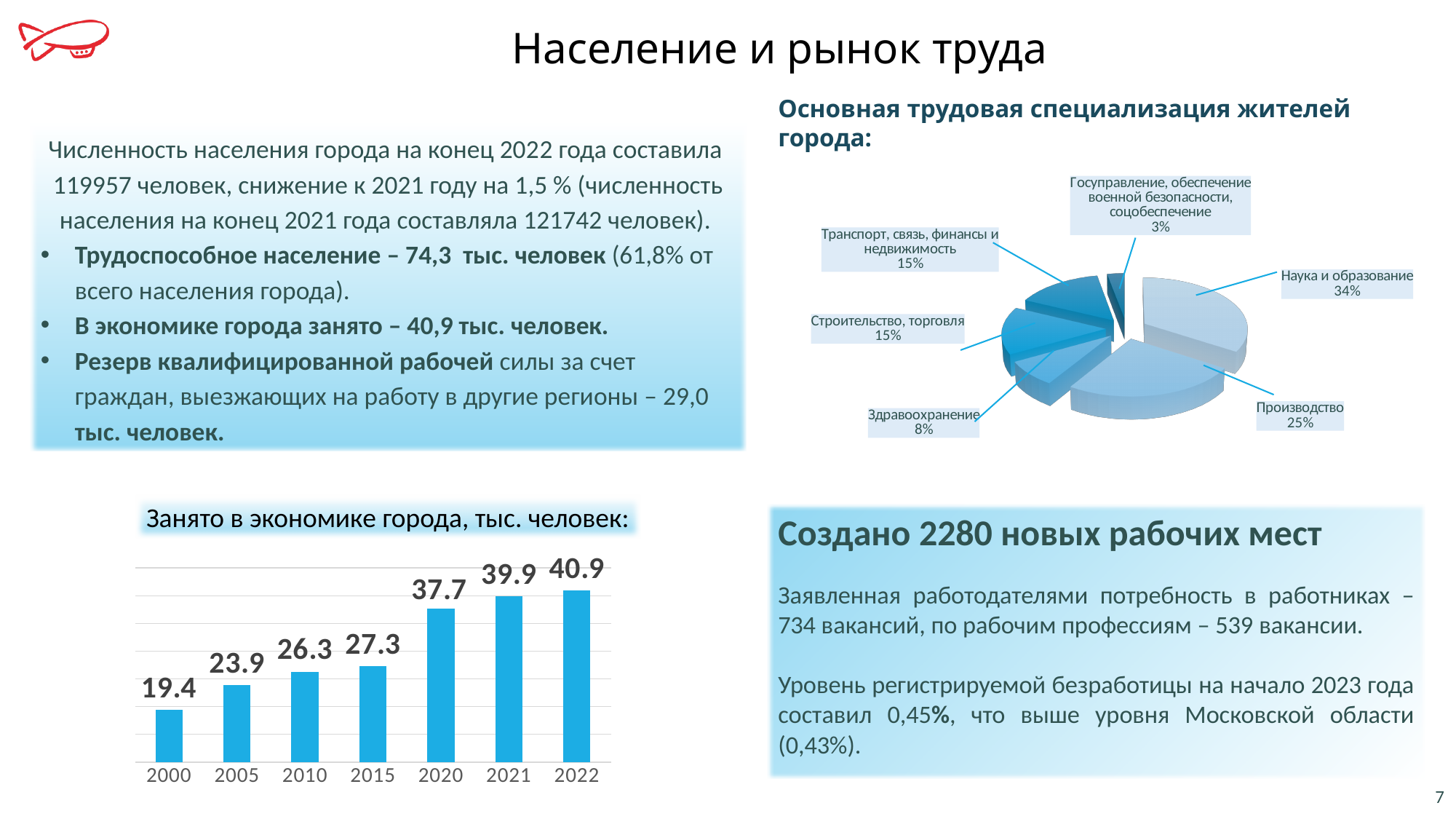
On the bar chart 'Занято в экономике города, тыс. человек', what is the difference between the values for 2022 and 2021? 1.0 On the bar chart 'Занято в экономике города, тыс. человек', what is the value for 2022? 40.9 On the pie chart 'Основная трудовая специализация жителей города', which is larger: 'Производство' or 'Здравоохранение'? Производство On the bar chart 'Занято в экономике города, тыс. человек', which year has the lowest value? 2000 On the bar chart 'Занято в экономике города, тыс. человек', how many years are shown? 7 On the pie chart 'Основная трудовая специализация жителей города', what share does 'Наука и образование' have? 34% On the bar chart 'Занято в экономике города, тыс. человек', which year has the highest value? 2022 On the bar chart 'Занято в экономике города, тыс. человек', what is the value for 2000? 19.4 What kind of chart is 'Занято в экономике города, тыс. человек'? bar chart On the pie chart 'Основная трудовая специализация жителей города', which category has the smallest share? Госуправление, обеспечение военной безопасности, соцобеспечение On the bar chart 'Занято в экономике города, тыс. человек', do the values rise or fall from 2000 to 2022? rise On the pie chart 'Основная трудовая специализация жителей города', how many slices are there? 6